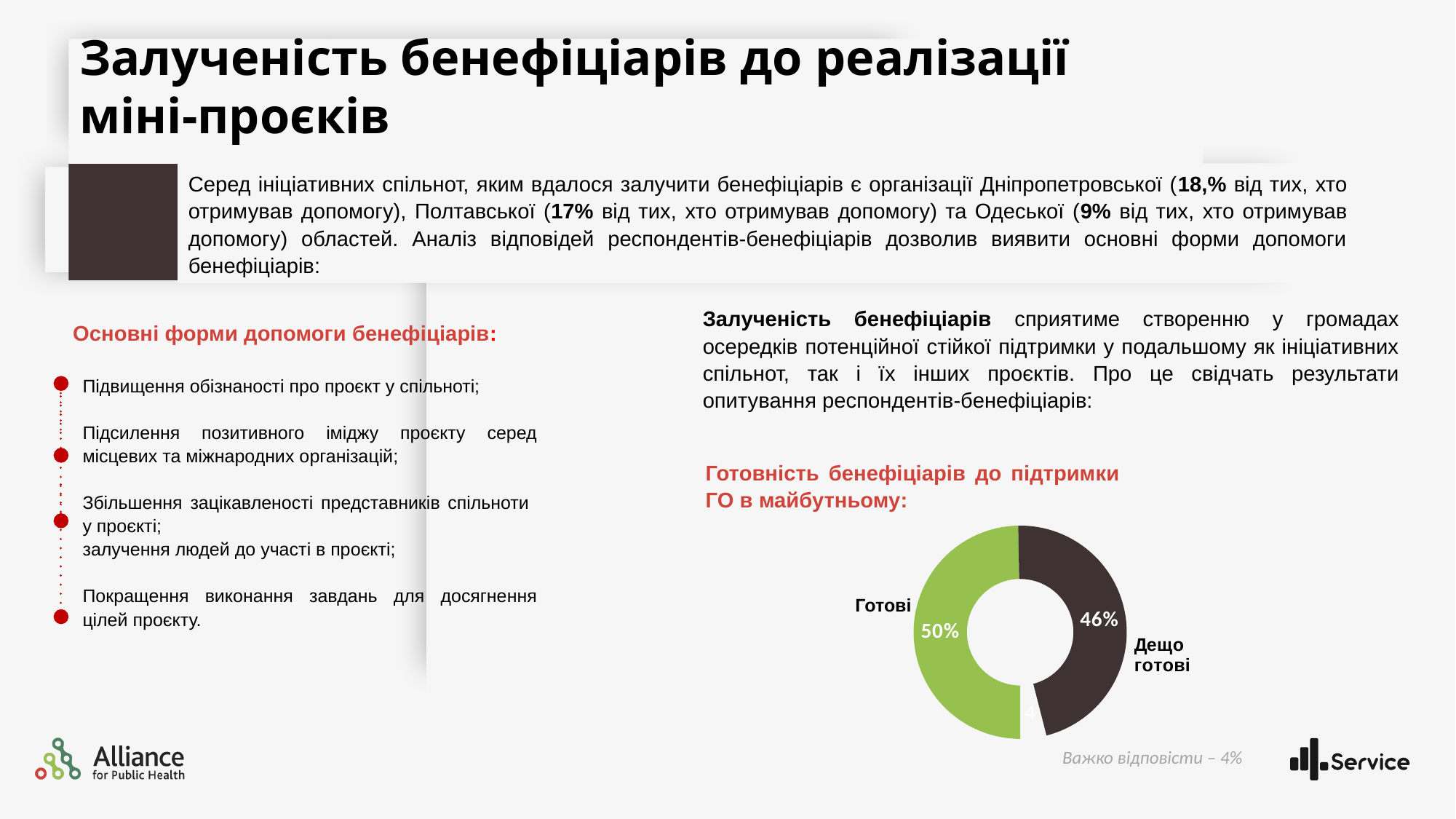
Which category has the largest share in the chart? Готові What type of chart is shown under "Готовність бенефіціарів до підтримки ГО в майбутньому"? Pie chart (donut) What is the title of the chart on the slide? Готовність бенефіціарів до підтримки ГО в майбутньому What colour is the "Готові" slice in the chart? Green What share of respondents are "Дещо готові" in the chart? 46% What is the difference in percentage points between "Готові" and "Дещо готові"? 4 Which category has the smallest share in the chart? Важко відповісти What is the difference in percentage points between "Дещо готові" and "Важко відповісти"? 42 What share of respondents are "Готові" in the chart? 50% How many categories does the chart show? 3 What share of respondents answered "Важко відповісти" in the chart? 4% Which is larger in the chart: "Готові" or "Дещо готові"? Готові